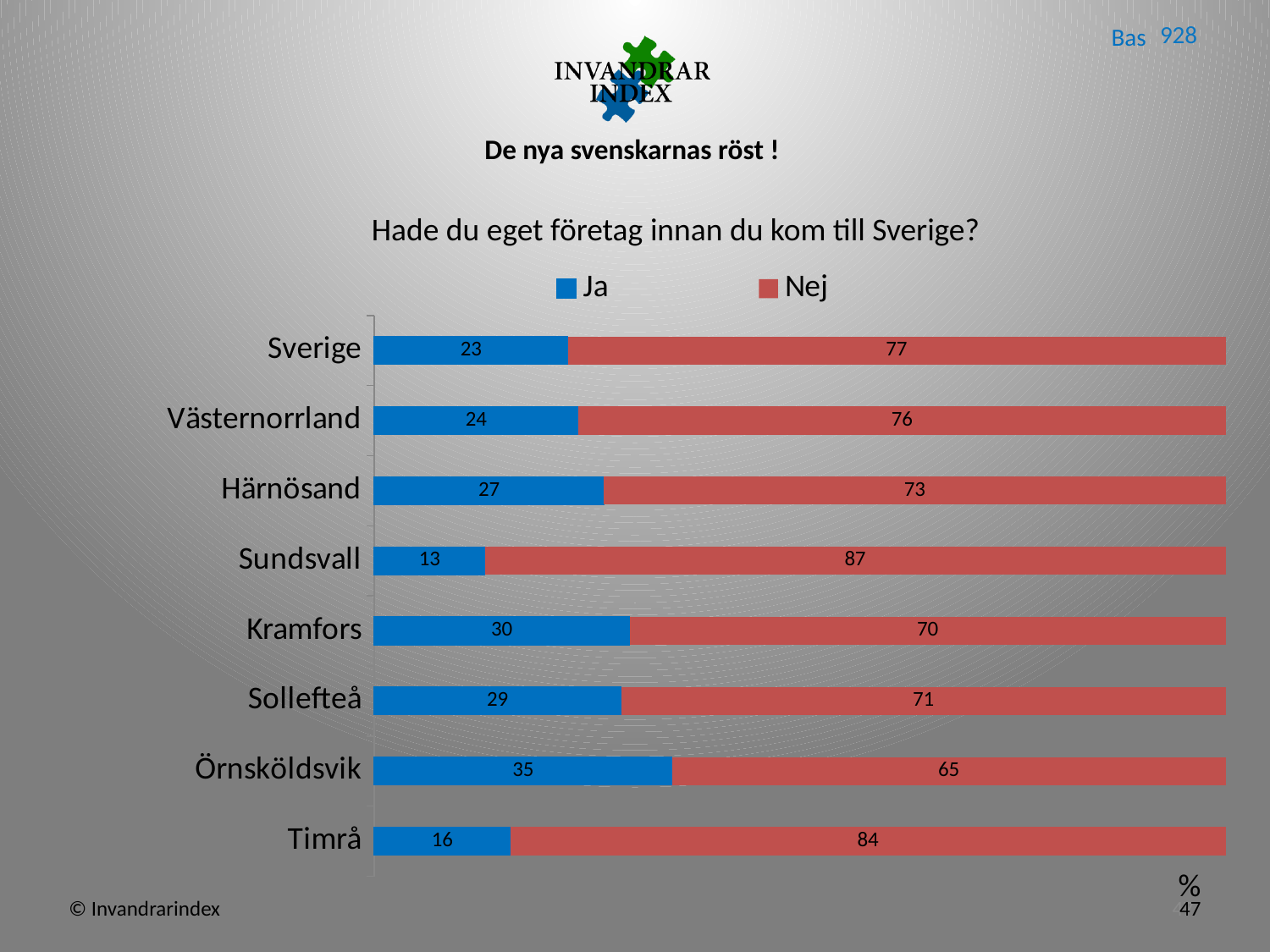
What is the 'Nej' value for Örnsköldsvik? 65 Which is larger, the 'Ja' value for Kramfors or the 'Ja' value for Sollefteå? Kramfors Which category has the highest 'Ja' value? Örnsköldsvik What is the total of the stacked bar for Härnösand? 100 What is the 'Ja' value for Västernorrland? 24 How many categories are shown on the chart? 8 Which category has the highest 'Nej' value? Sundsvall What is the 'Ja' value for Sundsvall? 13 What kind of chart is shown on the slide? Stacked bar chart How many series does the legend list? 2 What is the difference between the 'Nej' and 'Ja' values for Timrå? 68 Which category has the lowest 'Ja' value? Sundsvall